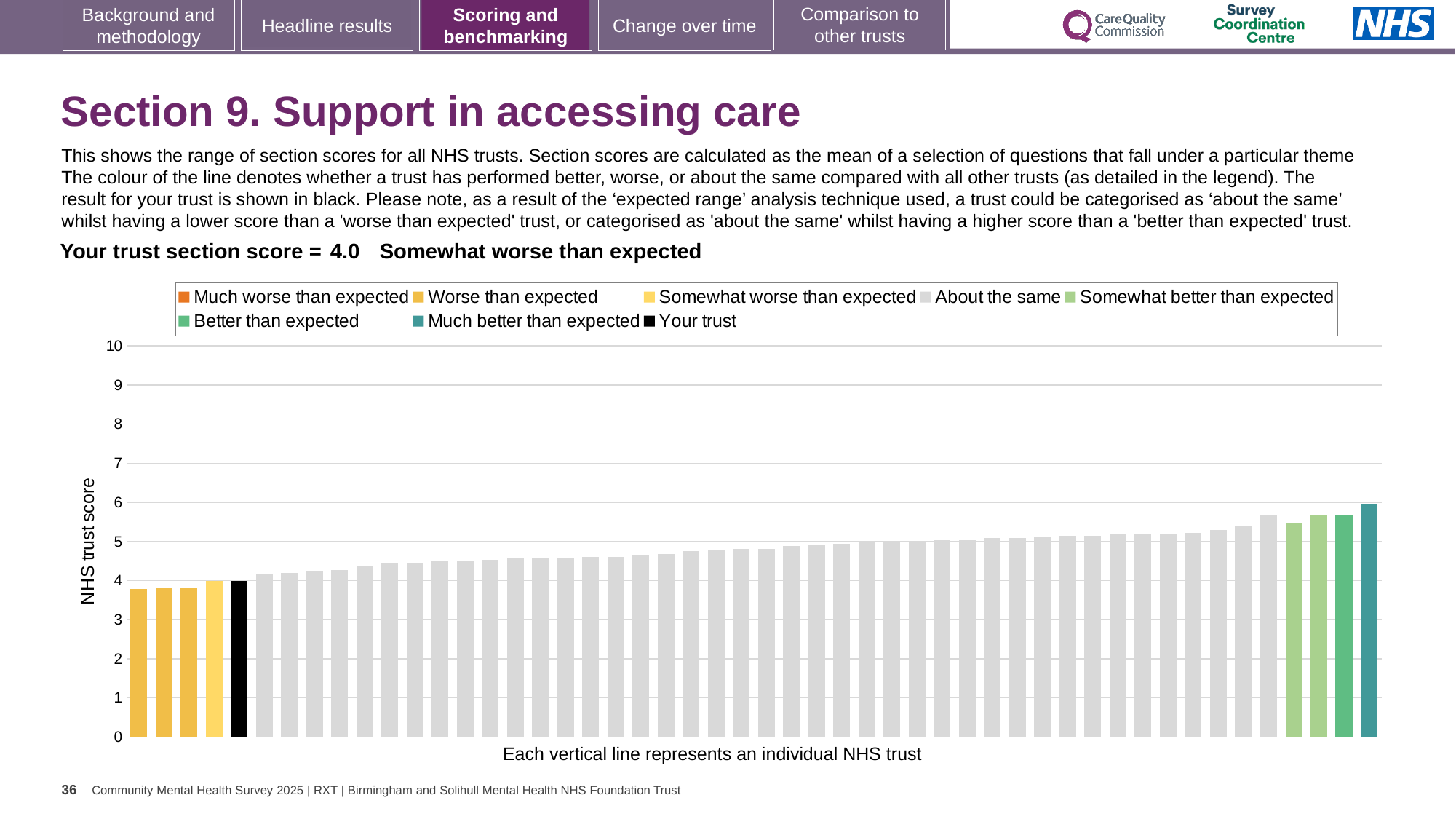
What is the section score for your trust shown on the slide? 4.0 Is the value for your trust greater or less than 5? less How many black bars (representing your trust) are in the chart? 1 How many entries does the chart legend list? 8 Is the value of the shortest bar in the chart greater or less than 5? less Which category does your trust's section score fall into, according to the slide? Somewhat worse than expected What kind of chart is shown on the slide? Bar chart Do the bar heights rise or fall from left to right across the chart? Rise Which is larger: the value for your trust or the value of the rightmost bar in the chart? The rightmost bar Is the value of the tallest bar in the chart greater or less than 5? greater What is the label on the vertical axis of the chart? NHS trust score What is the highest value shown on the vertical axis of the chart? 10